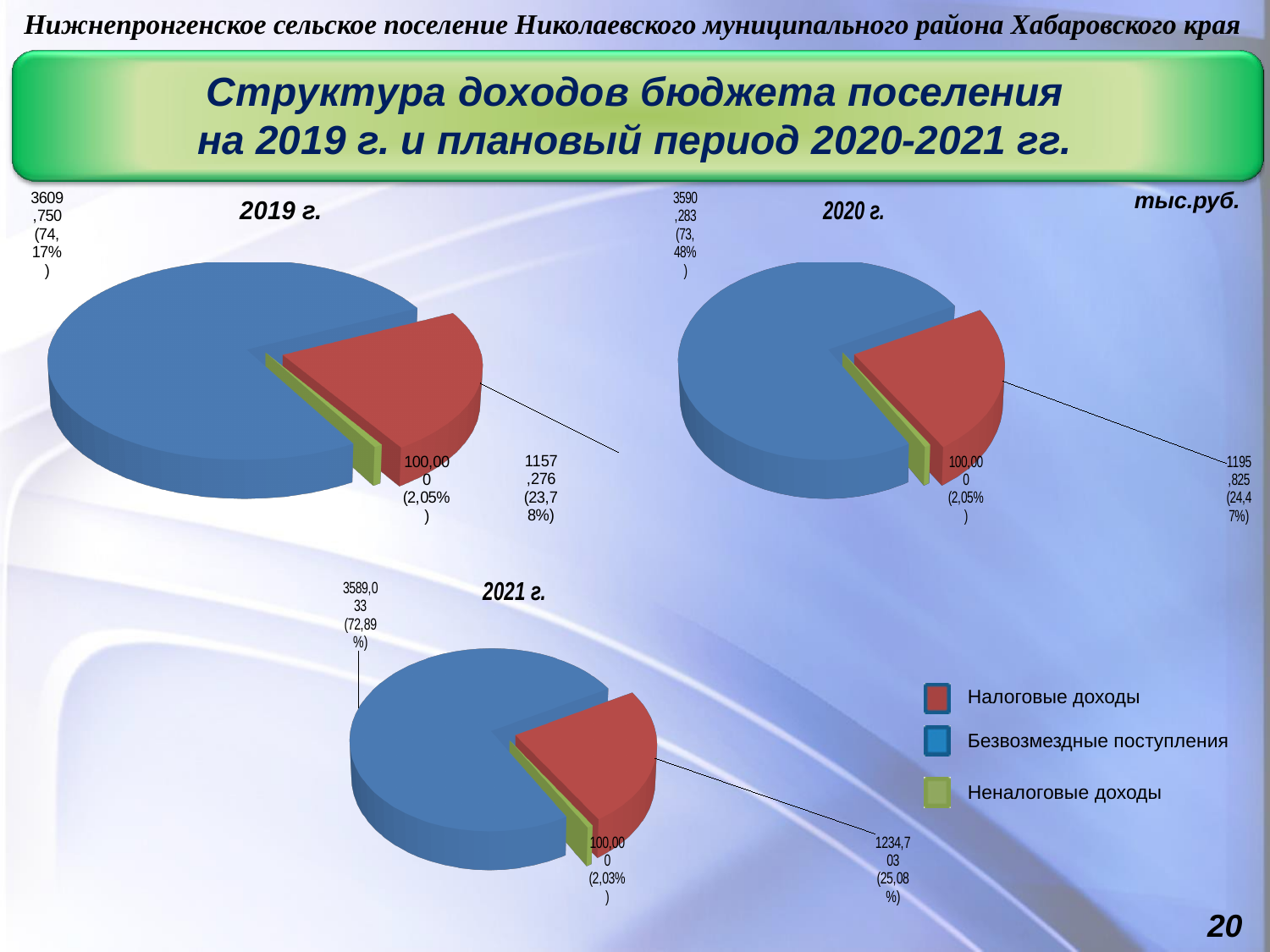
In the 2021 г. chart, what value is shown for Неналоговые доходы? 100,000 (2,03%) How many categories does the legend list for the pie charts? 3 In the 2021 г. chart, which category has the largest slice? Безвозмездные поступления What kind of chart is used for the 2019 г. chart? pie chart In the 2021 г. chart, what share of the pie is Налоговые доходы? 25,08% In the 2020 г. chart, what share of the pie is Безвозмездные поступления? 73,48% In the 2020 г. chart, what value is shown for Налоговые доходы? 1195,825 (24,47%) In the 2019 г. chart, what value is shown for Безвозмездные поступления? 3609,750 (74,17%) In the 2020 г. chart, which category has the smallest slice? Неналоговые доходы In the 2019 г. chart, what share of the pie is Налоговые доходы? 23,78% What unit of measurement is indicated for the values on the slide? тыс.руб. In the 2019 г. chart, which is larger: Налоговые доходы or Неналоговые доходы? Налоговые доходы